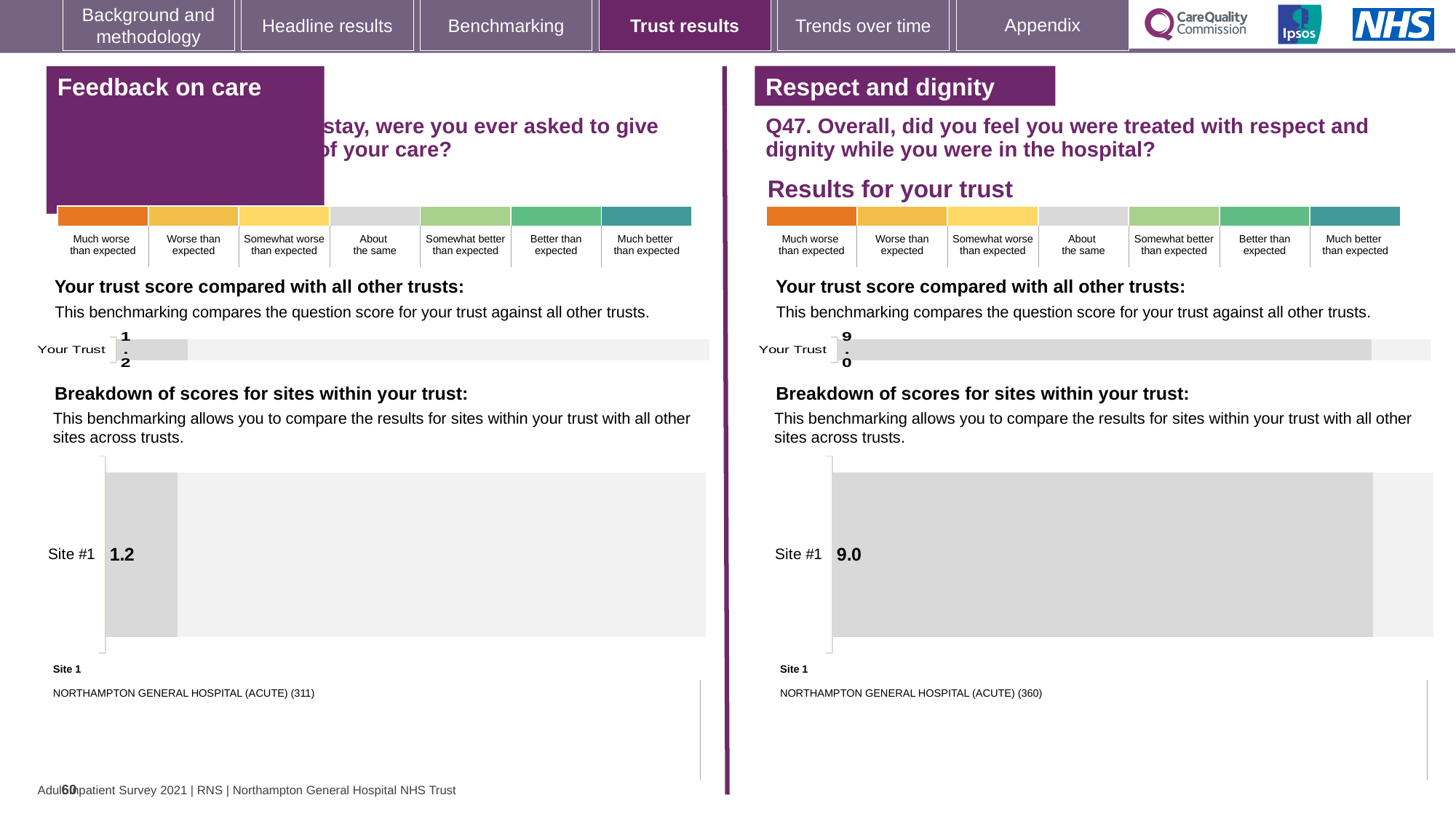
What type of chart is used to show the Site #1 score in the Feedback on care section? Bar chart How many sites are shown in the breakdown of scores chart in the Respect and dignity section? 1 In the Feedback on care section, what is the score shown for Your Trust in the trust comparison chart? 1.2 In the Respect and dignity section, what score is shown for Site #1 in the breakdown of scores for sites chart? 9.0 What type of chart is used to show the Your Trust score in the Respect and dignity section? Bar chart Which is larger: the Site #1 score in the Respect and dignity section or the Site #1 score in the Feedback on care section? Respect and dignity Which site is listed as Site 1 below the breakdown chart in the Respect and dignity section? NORTHAMPTON GENERAL HOSPITAL (ACUTE) (360) What is the difference between the Site #1 score in the Respect and dignity section and the Site #1 score in the Feedback on care section? 7.8 Which site is listed as Site 1 below the breakdown chart in the Feedback on care section? NORTHAMPTON GENERAL HOSPITAL (ACUTE) (311) In the Respect and dignity section, what is the score shown for Your Trust in the trust comparison chart? 9.0 How many sites are shown in the breakdown of scores chart in the Feedback on care section? 1 In the Feedback on care section, what score is shown for Site #1 in the breakdown of scores for sites chart? 1.2